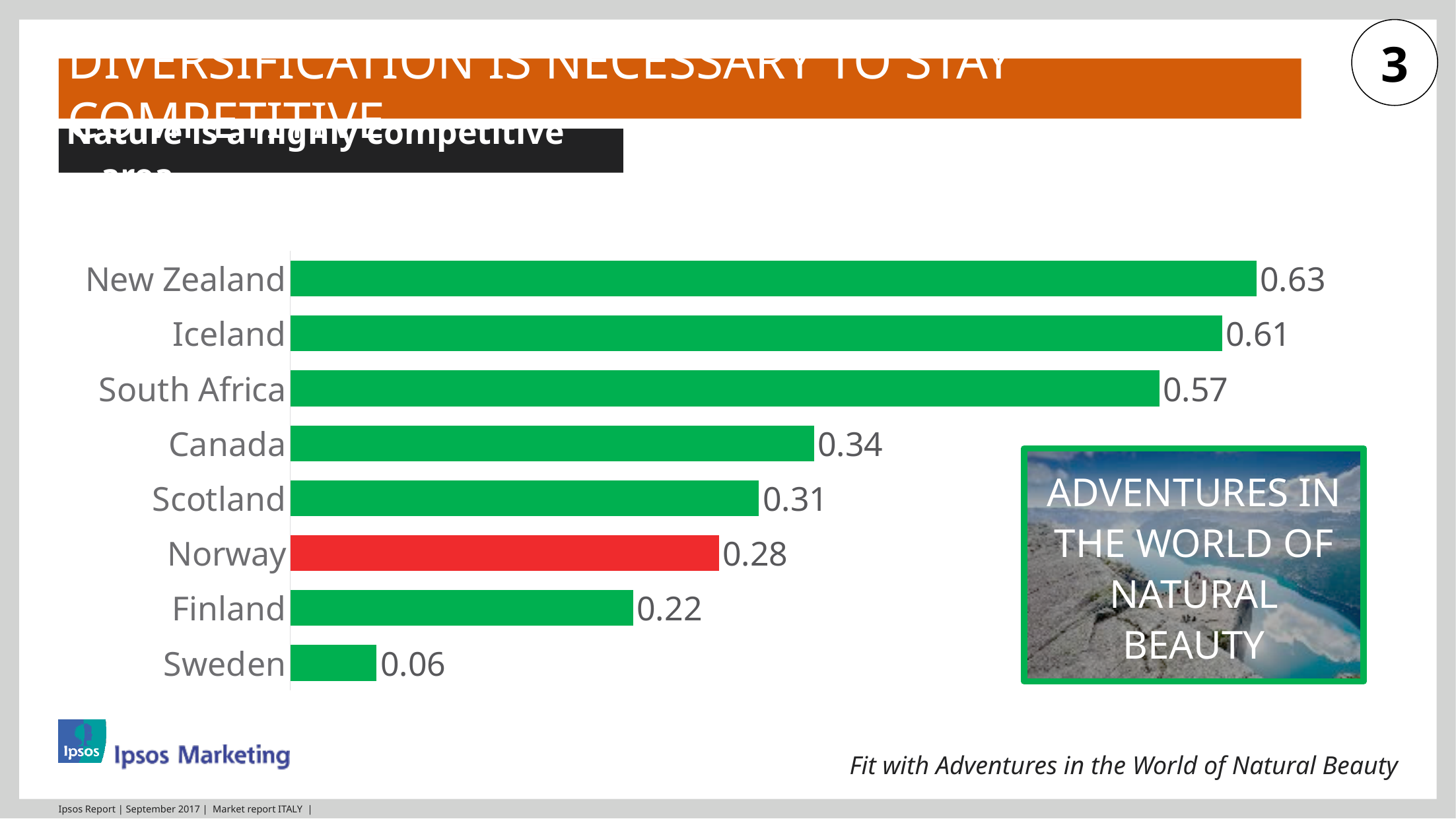
Which country's bar is coloured red instead of green? Norway Which country has the lowest value? Sweden What is the value for Sweden? 0.06 What is the value for Norway? 0.28 What is the difference between the values for Norway and Finland? 0.06 What kind of chart is shown on the slide? Bar chart Which country has the highest value? New Zealand Which has a larger value, South Africa or Scotland? South Africa What is the value for Canada? 0.34 What is the value for New Zealand? 0.63 What is the difference between the values for New Zealand and Iceland? 0.02 How many countries are shown in the chart? 8